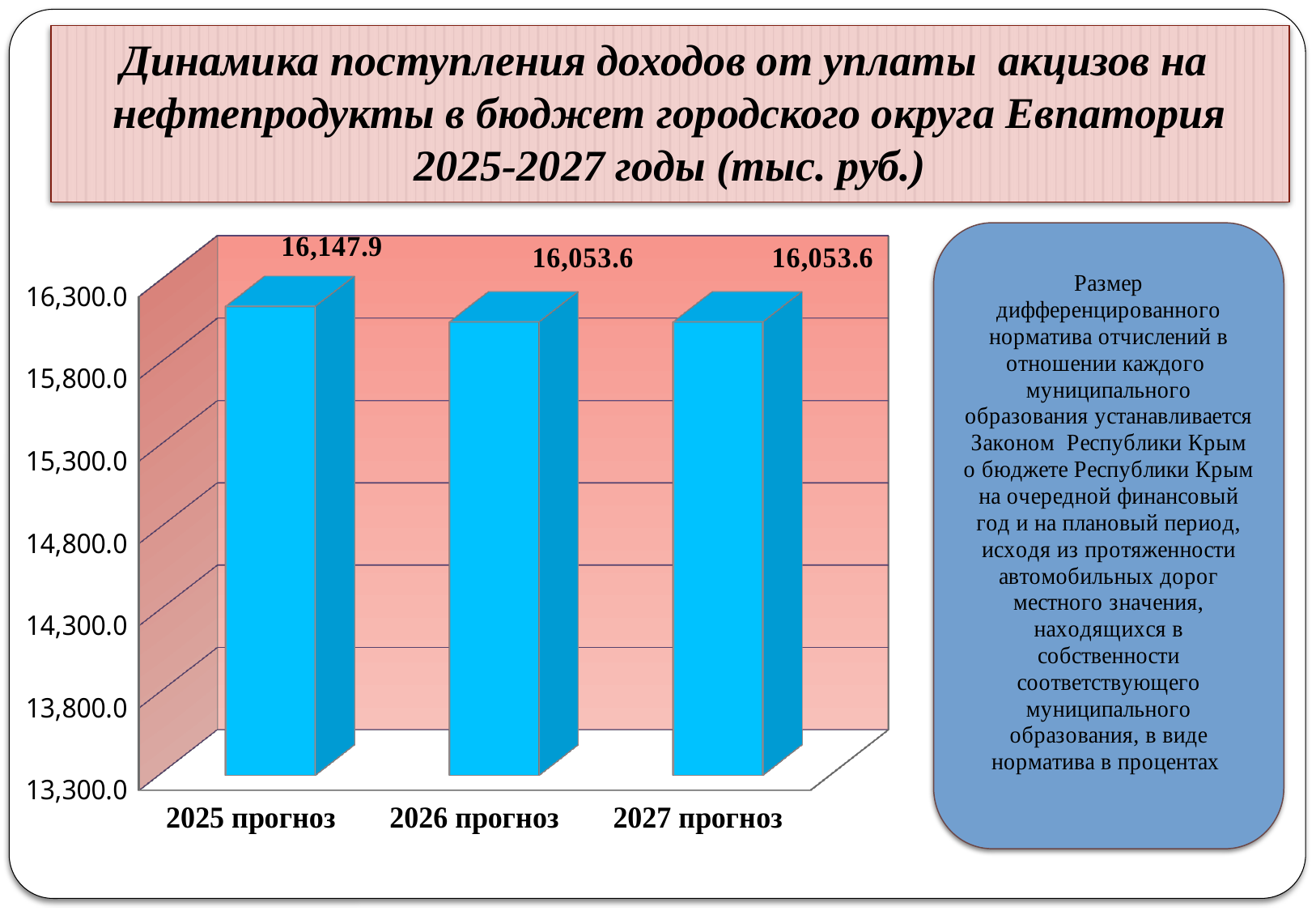
What is the value for 2027 прогноз? 16,053.6 Are the values for 2026 прогноз and 2027 прогноз equal? Yes, both are 16,053.6 Which is larger, the value for 2025 прогноз or the value for 2027 прогноз? 2025 прогноз What kind of chart is shown on the slide? bar chart How many categories are shown on the x axis? 3 What colour are the bars in the chart? blue What is the difference between the values for 2025 прогноз and 2026 прогноз? 94.3 Which category has the highest value? 2025 прогноз What is the value for 2026 прогноз? 16,053.6 What is the value for 2025 прогноз? 16,147.9 Is the value for 2026 прогноз greater or less than 15,800.0? greater How do the values change from 2025 прогноз to 2027 прогноз? They fall from 2025 to 2026, then stay the same in 2027